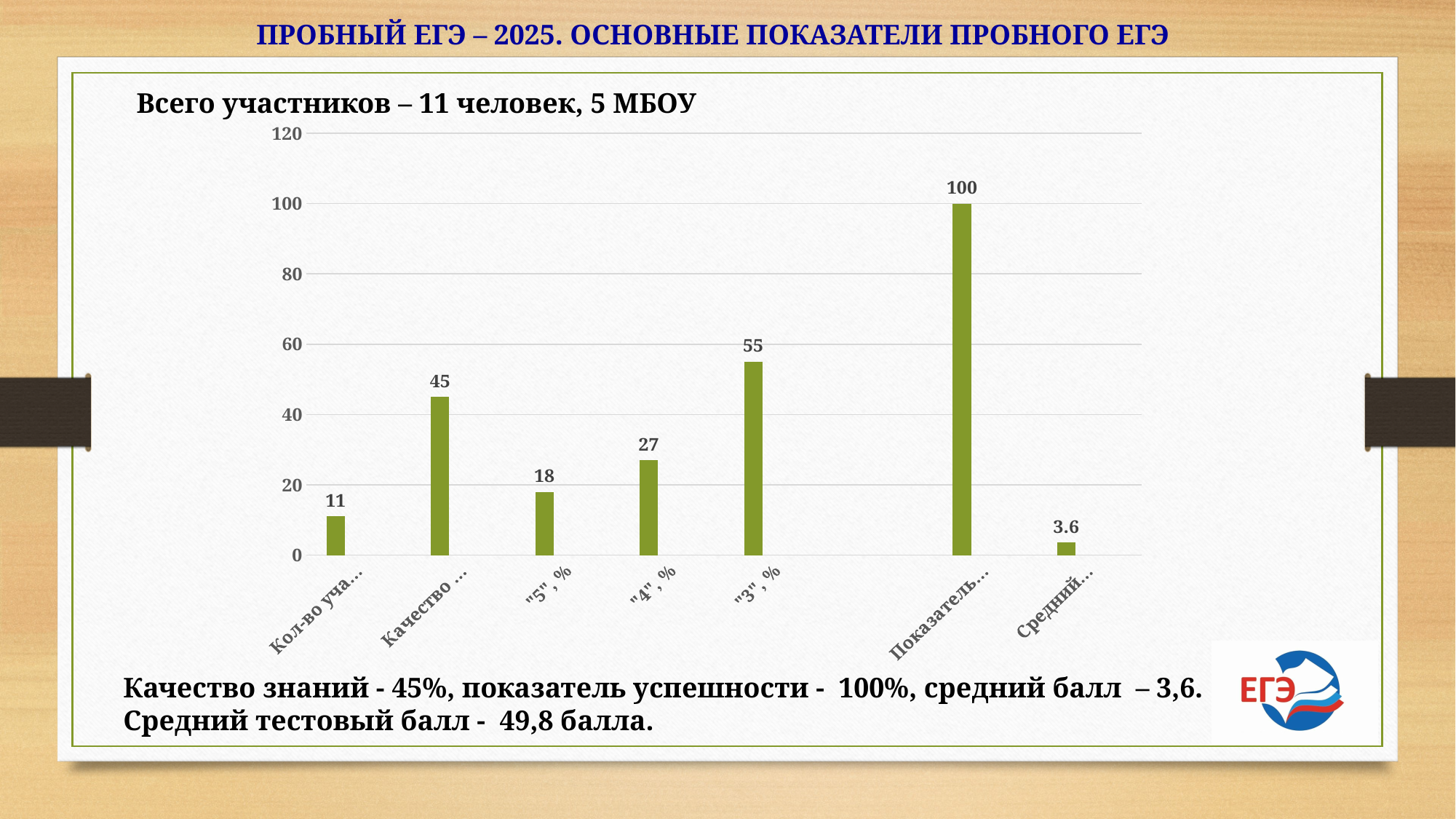
What type of chart is shown on the slide? bar chart Which category has the lowest bar in the chart? Средний… Which is larger, the value for "5", % or the value for "4", %? "4", % What is the difference between the values for "3", % and "4", %? 28 How many bars (categories) does the chart show? 7 What is the highest value shown on the vertical axis of the chart? 120 What is the value of the bar labelled "3", %? 55 What is the value of the bar labelled "4", %? 27 What is the value of the first bar, labelled "Кол-во уча…"? 11 Which category has the highest bar in the chart? Показатель… What is the value of the bar labelled "5", %? 18 What is the value of the last bar, labelled "Средний…"? 3.6